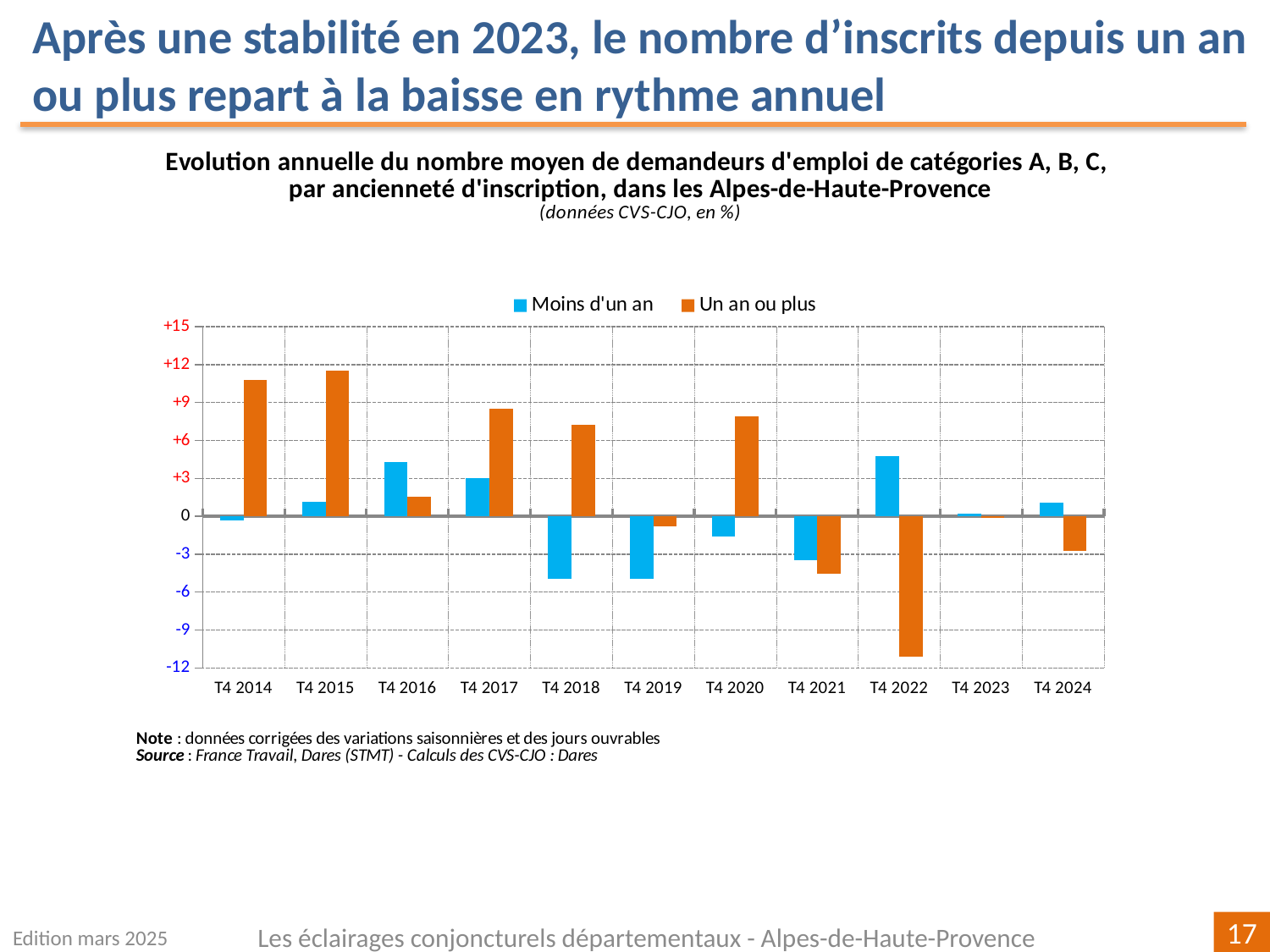
In T4 2020, which series has the larger value, 'Moins d'un an' or 'Un an ou plus'? Un an ou plus How many periods (categories) are shown on the x axis? 11 Is the value for 'Un an ou plus' in T4 2022 greater or less than -9? less Is the value for 'Un an ou plus' in T4 2014 greater or less than +9? greater What kind of chart is shown on the slide? bar chart How many series does the legend list? 2 Is the value for 'Moins d'un an' in T4 2018 greater or less than -3? less Which period has the lowest value for the series 'Un an ou plus'? T4 2022 Which colour represents the series 'Un an ou plus' in the legend? orange In T4 2022, which series has the larger value, 'Moins d'un an' or 'Un an ou plus'? Moins d'un an